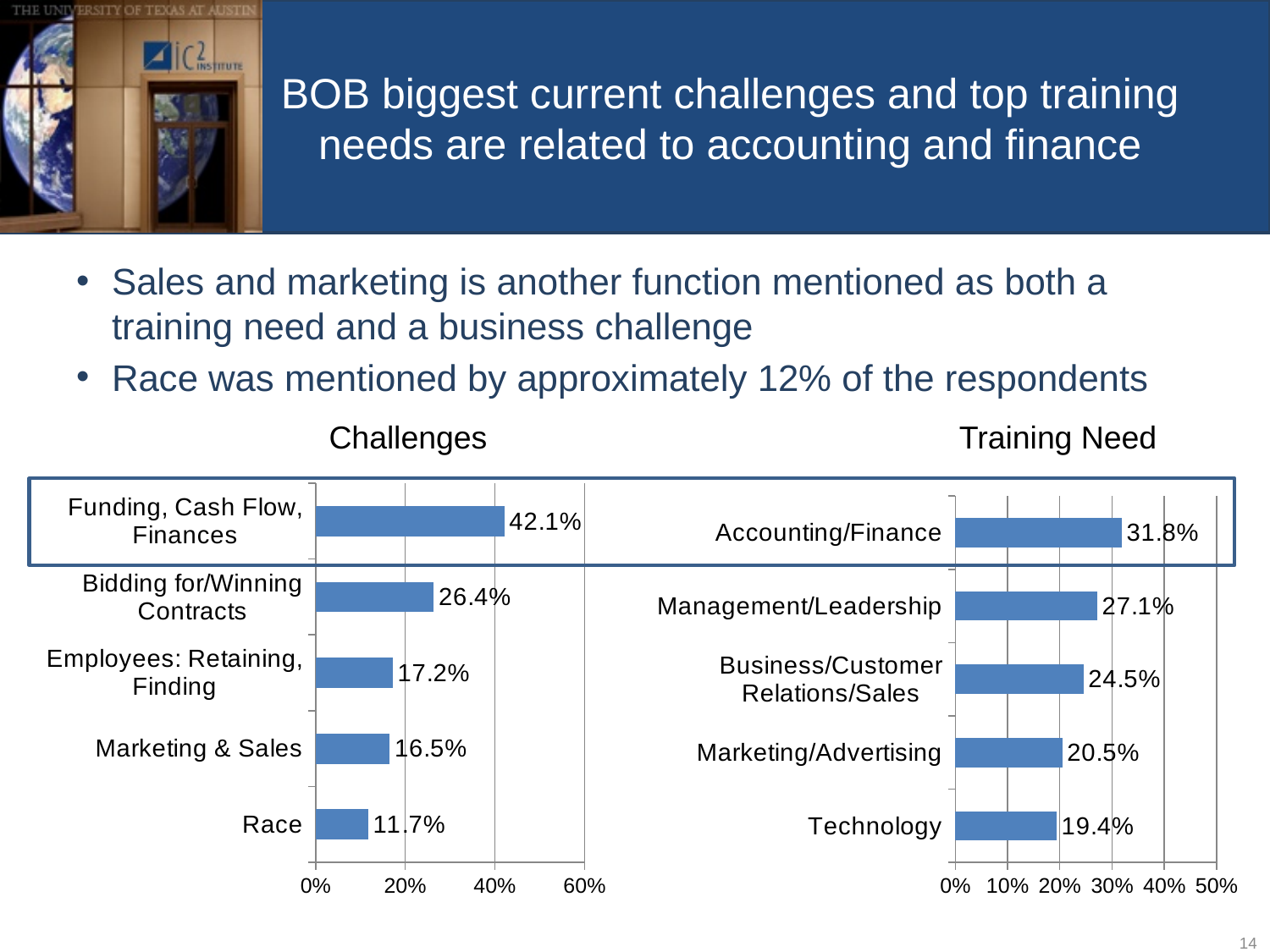
In the Training Need chart, which category has the highest value? Accounting/Finance In the Challenges chart, which category has the lowest value? Race In the Training Need chart, what is the difference between Accounting/Finance and Technology? 12.4% How many categories are shown in the Challenges chart? 5 In the Training Need chart, what is the value for Management/Leadership? 27.1% In the Challenges chart, is the value for Bidding for/Winning Contracts greater or less than 20%? greater In the Training Need chart, which is larger: Business/Customer Relations/Sales or Marketing/Advertising? Business/Customer Relations/Sales What type of chart is the Challenges chart? Bar chart In the Challenges chart, what is the difference between Funding, Cash Flow, Finances and Bidding for/Winning Contracts? 15.7% In the Training Need chart, what is the value for Technology? 19.4% How many categories are shown in the Training Need chart? 5 In the Challenges chart, what is the value for Funding, Cash Flow, Finances? 42.1%